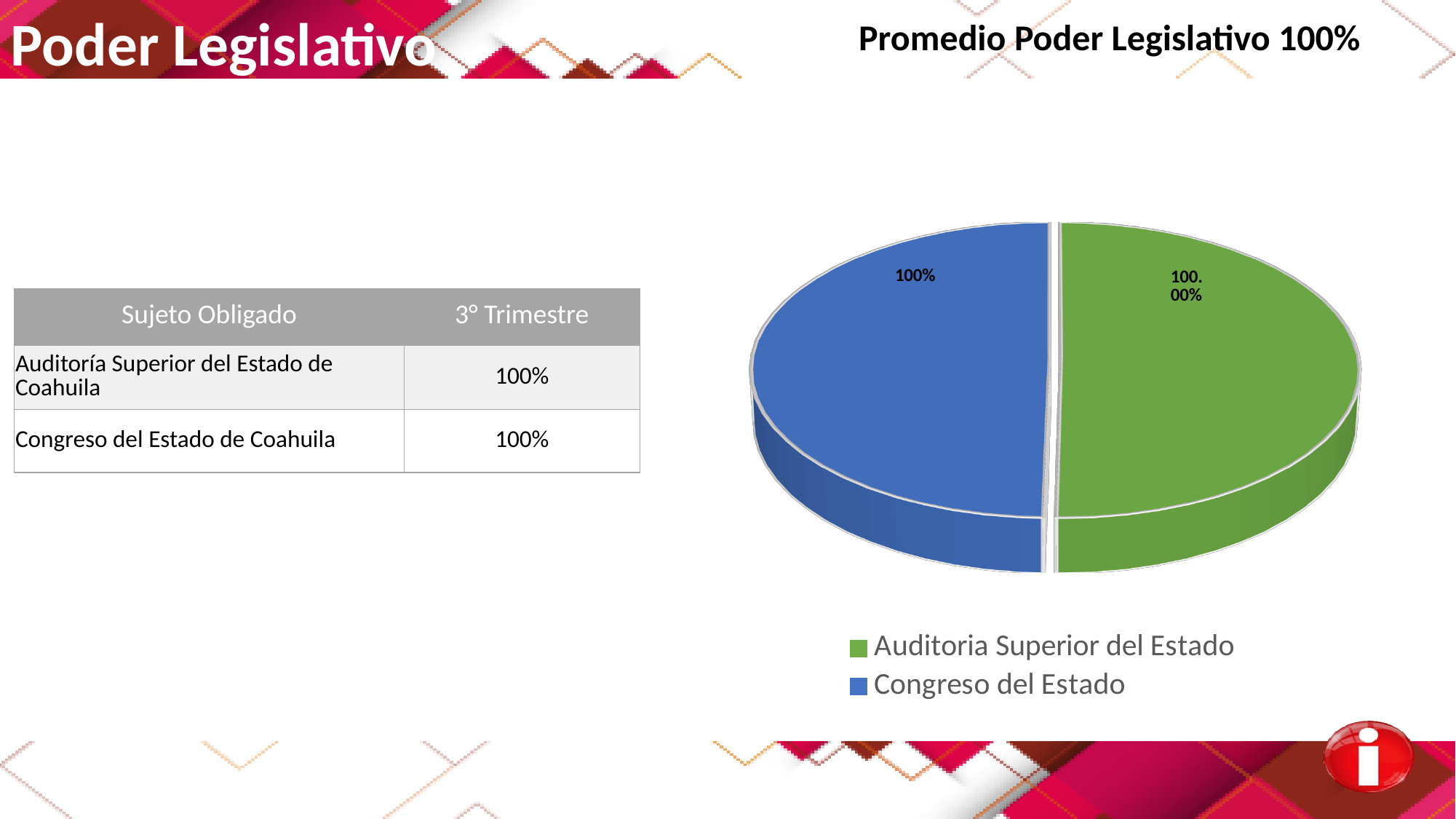
Which colour represents Auditoria Superior del Estado in the pie chart? green What kind of chart is shown on the slide? pie chart What value is printed on the Congreso del Estado slice of the pie chart? 100% What is the difference between the values printed for Auditoria Superior del Estado and Congreso del Estado in the pie chart? 0% Which colour represents Congreso del Estado in the pie chart? blue What value is printed on the Auditoria Superior del Estado slice of the pie chart? 100.00% How many slices does the pie chart have? 2 How many entries does the legend of the pie chart list? 2